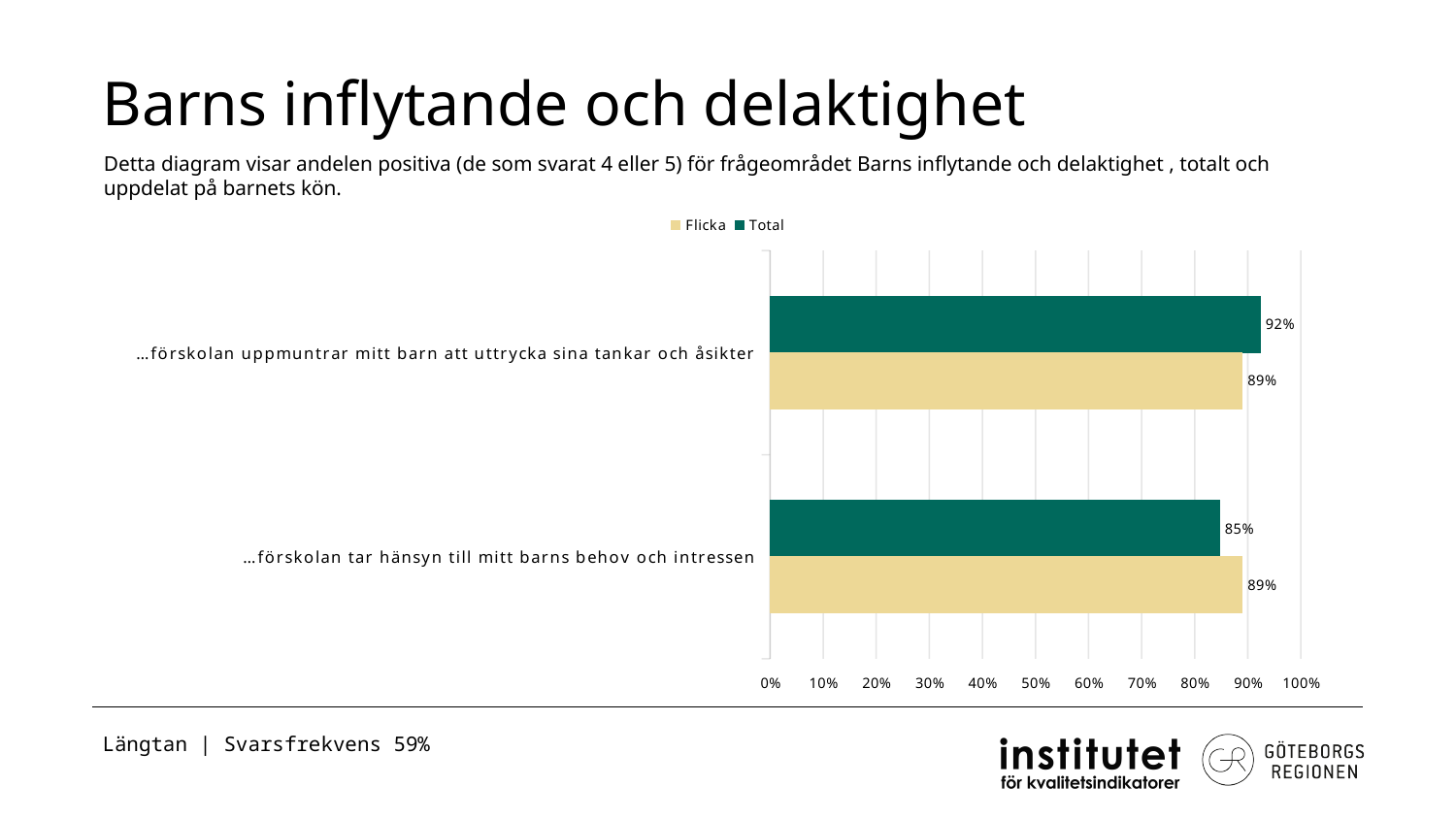
What is the Total value for "…förskolan tar hänsyn till mitt barns behov och intressen"? 85% How many series does the legend list? 2 How many categories are shown on the chart? 2 Which series is shown in dark green in the legend? Total What is the Flicka value for "…förskolan tar hänsyn till mitt barns behov och intressen"? 89% For "…förskolan uppmuntrar mitt barn att uttrycka sina tankar och åsikter", which is larger, the Total value or the Flicka value? Total What is the Flicka value for "…förskolan uppmuntrar mitt barn att uttrycka sina tankar och åsikter"? 89% What is the difference between the Total and Flicka values for "…förskolan tar hänsyn till mitt barns behov och intressen"? 4% What type of chart is shown on the slide? bar chart Which category has the highest Total value? …förskolan uppmuntrar mitt barn att uttrycka sina tankar och åsikter What is the Total value for "…förskolan uppmuntrar mitt barn att uttrycka sina tankar och åsikter"? 92% Which category has the lowest Total value? …förskolan tar hänsyn till mitt barns behov och intressen